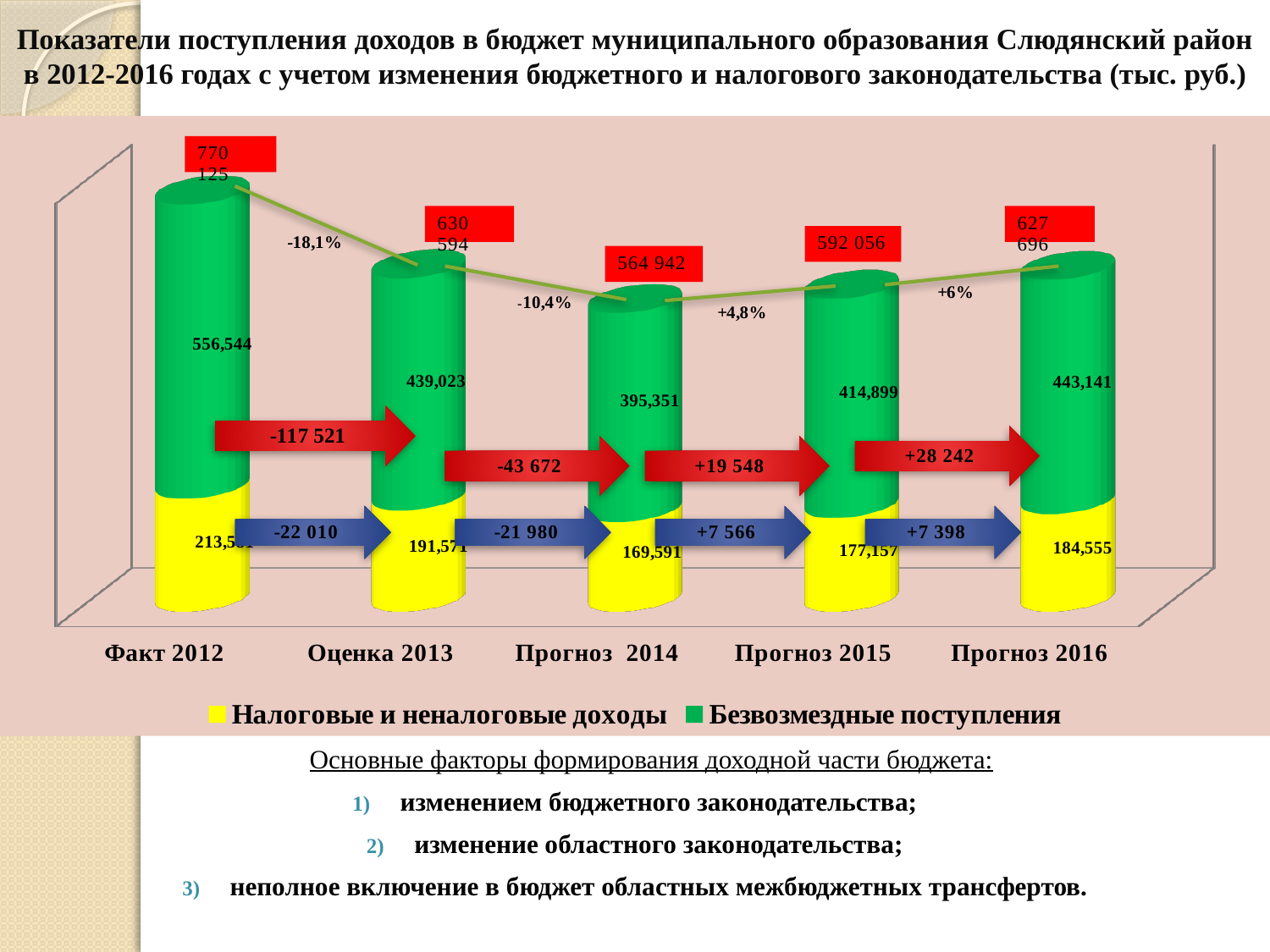
How many categories are shown on the x axis? 5 What is the value of Безвозмездные поступления for Прогноз 2014? 395,351 Which category has the highest value of Безвозмездные поступления? Факт 2012 Which category has the lowest value of Налоговые и неналоговые доходы? Прогноз 2014 Which is larger, Безвозмездные поступления for Прогноз 2015 or for Прогноз 2016? Прогноз 2016 What percentage change is shown between Факт 2012 and Оценка 2013? -18,1% What is the value of Налоговые и неналоговые доходы for Прогноз 2015? 177,157 What is the value of Налоговые и неналоговые доходы for Прогноз 2016? 184,555 What is the total shown above the bar for Оценка 2013? 630 594 How many series does the legend list? 2 What type of chart is shown on the slide? bar chart What is the value of Безвозмездные поступления for Факт 2012? 556,544